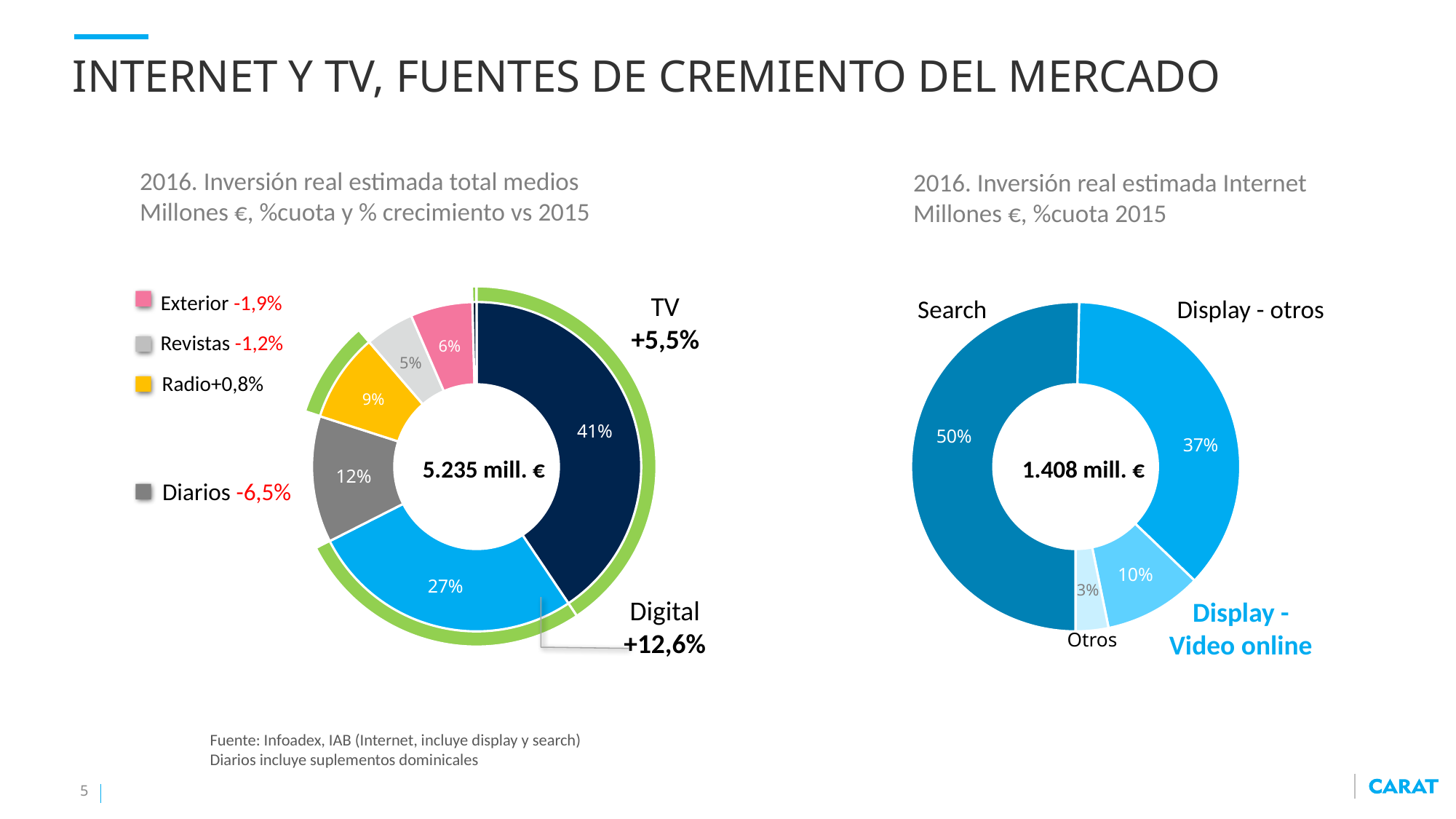
In the left chart (2016 total media investment), what growth vs 2015 is shown for Diarios? -6,5% In the right chart (2016 Internet investment), which is larger, Display - otros or Display - Video online? Display - otros In the left chart (2016 total media investment), which medium has the largest share? TV In the left chart (2016 total media investment), what share does Digital hold? 27% In the left chart (2016 total media investment), how many media categories are plotted? 6 In the left chart (2016 total media investment), what total investment figure is shown in the centre of the donut? 5.235 mill. € In the right chart (2016 Internet investment), which category has the smallest share? Otros In the left chart (2016 total media investment), what share does TV hold? 41% In the left chart (2016 total media investment), what is the difference in share between TV and Digital? 14 percentage points In the right chart (2016 Internet investment), what share does Search hold? 50% In the left chart (2016 total media investment), which medium has the smallest share? Revistas What kind of chart is used on the right side of the slide (2016 Internet investment)? Donut (pie) chart